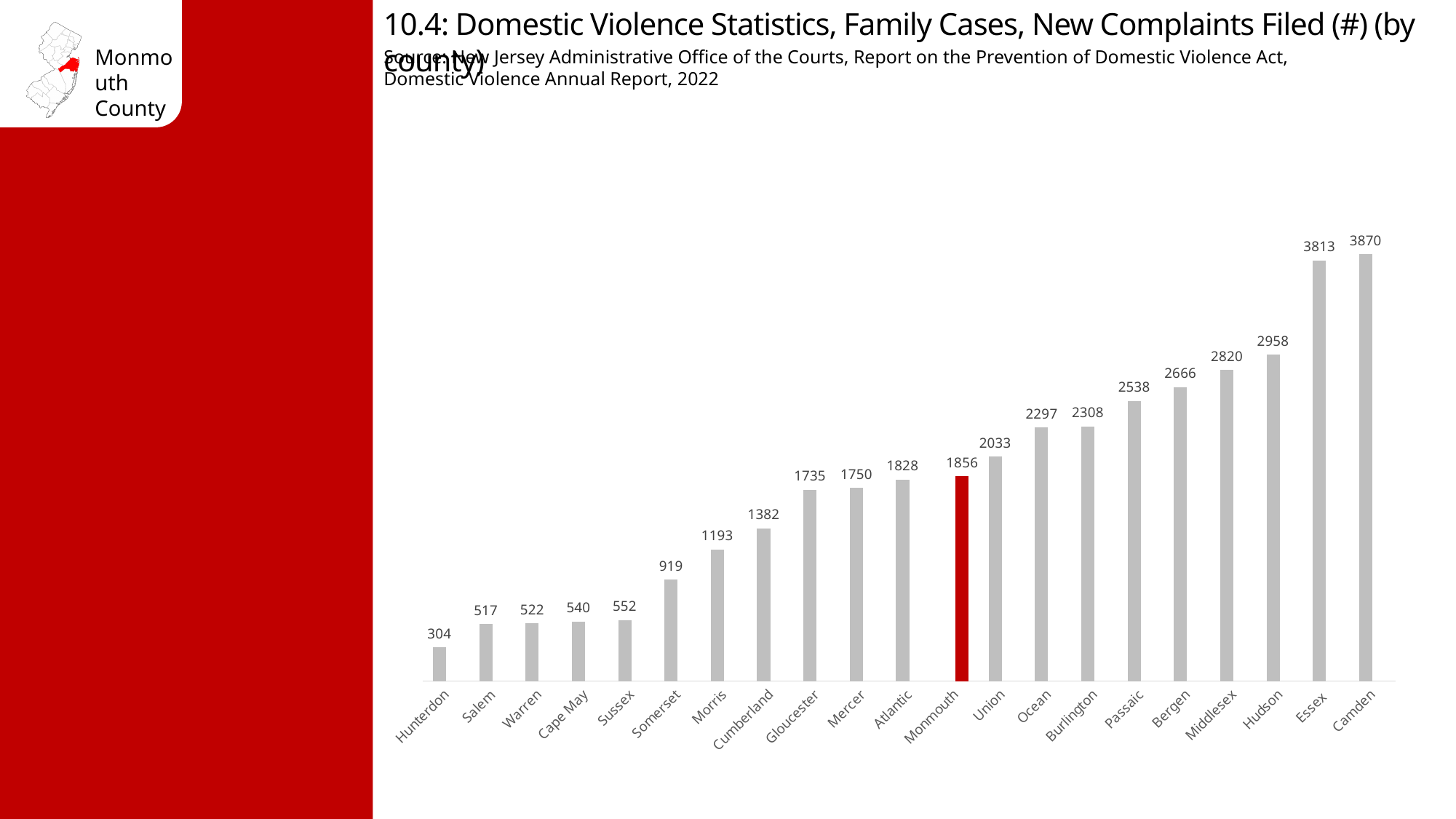
Which county's bar is highlighted in red? Monmouth What is the difference between the values for Monmouth and Atlantic? 28 Which county has the highest number of new complaints filed? Camden What kind of chart is shown on the slide? Bar chart Which has a larger value, Ocean or Morris? Ocean Which county has the lowest number of new complaints filed? Hunterdon What is the value shown for Hunterdon? 304 Do the values rise or fall moving from left to right along the x axis? Rise What is the difference between the values for Camden and Essex? 57 What is the value shown for Bergen? 2666 How many counties are shown on the chart? 21 What is the number of new domestic violence complaints filed for Monmouth? 1856